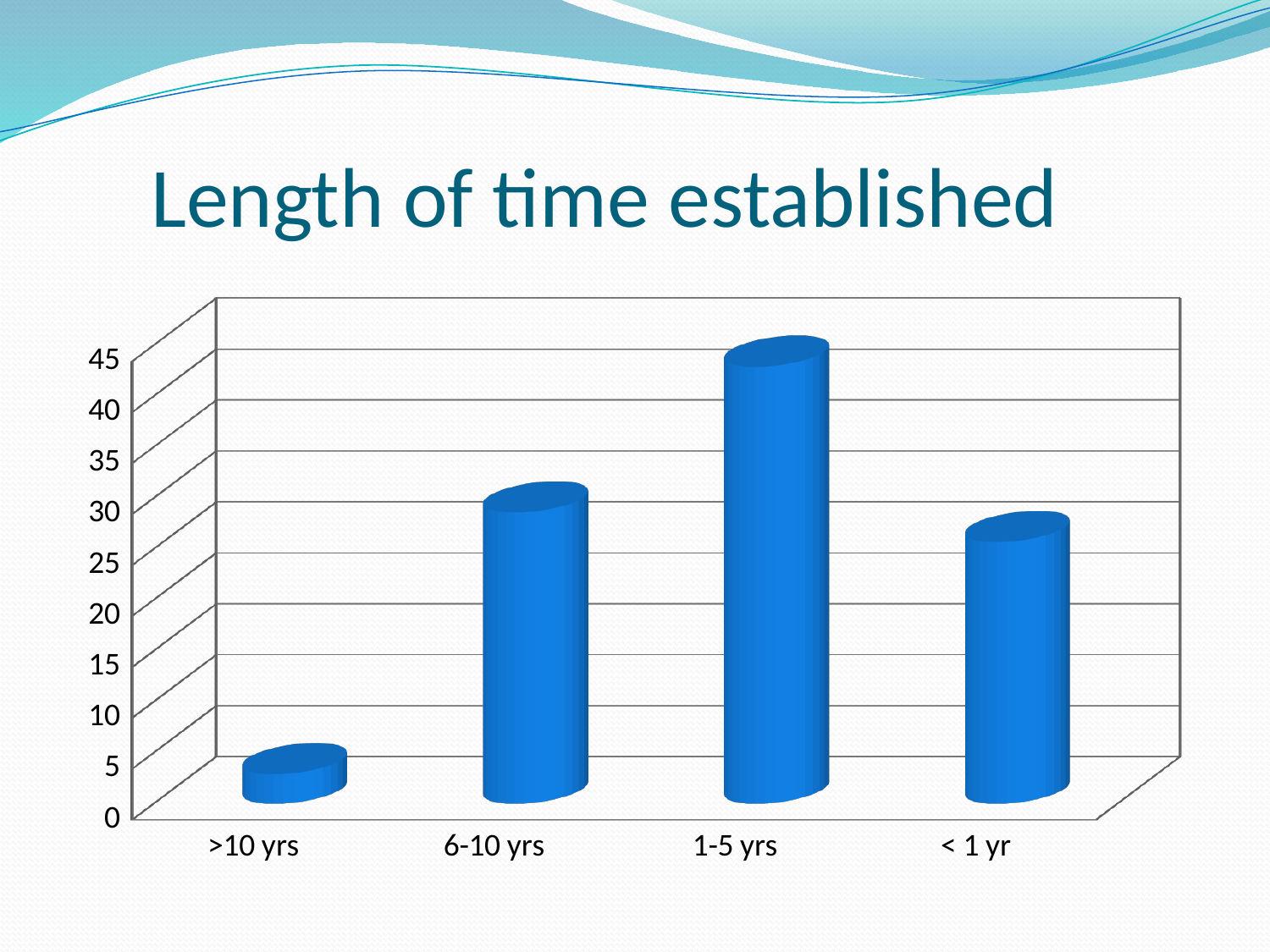
Which category has the lowest value? >10 yrs Is the value for 6-10 yrs greater or less than 25? greater Which is larger, the value for < 1 yr or the value for >10 yrs? < 1 yr Which category has the highest value? 1-5 yrs Which is larger, the value for 1-5 yrs or the value for 6-10 yrs? 1-5 yrs What is the title of the chart? Length of time established What type of chart is shown on the slide? bar chart Is the value for < 1 yr greater or less than 35? less Is the value for < 1 yr greater or less than 20? greater How many categories are shown on the x axis? 4